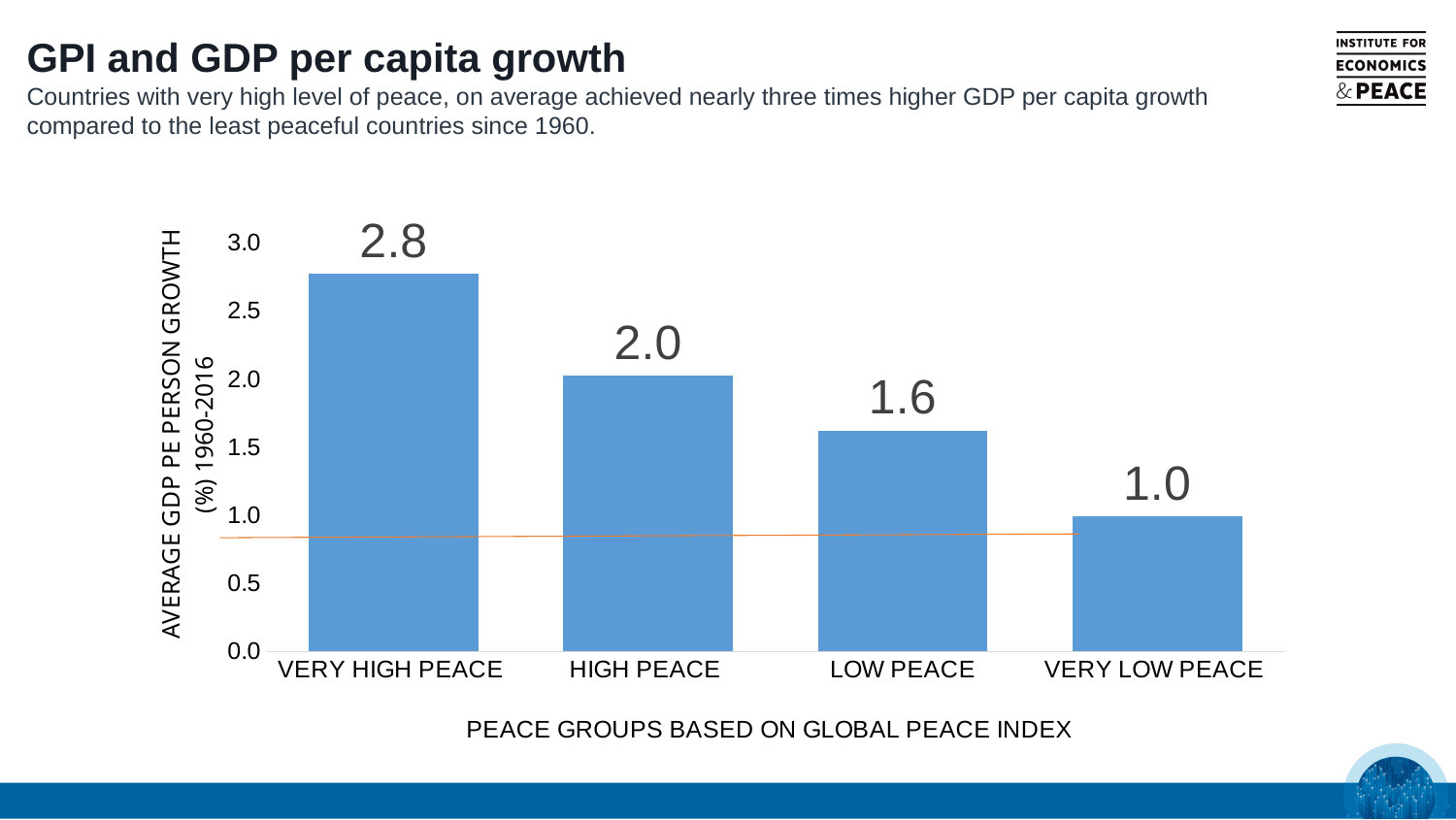
What kind of chart is shown on the slide? Bar chart What is the difference in average GDP per person growth between the VERY HIGH PEACE and VERY LOW PEACE groups? 1.8 Do the values rise or fall moving from VERY HIGH PEACE to VERY LOW PEACE along the x axis? Fall Which peace group has the lowest average GDP per person growth? VERY LOW PEACE What is the average GDP per person growth for the VERY HIGH PEACE group? 2.8 Which has a higher average GDP per person growth, HIGH PEACE or LOW PEACE? HIGH PEACE What is the average GDP per person growth for the LOW PEACE group? 1.6 Which peace group has the highest average GDP per person growth? VERY HIGH PEACE What is the average GDP per person growth for the HIGH PEACE group? 2.0 How many peace groups are shown on the x axis? 4 What is the x-axis title of the chart? PEACE GROUPS BASED ON GLOBAL PEACE INDEX What is the average GDP per person growth for the VERY LOW PEACE group? 1.0